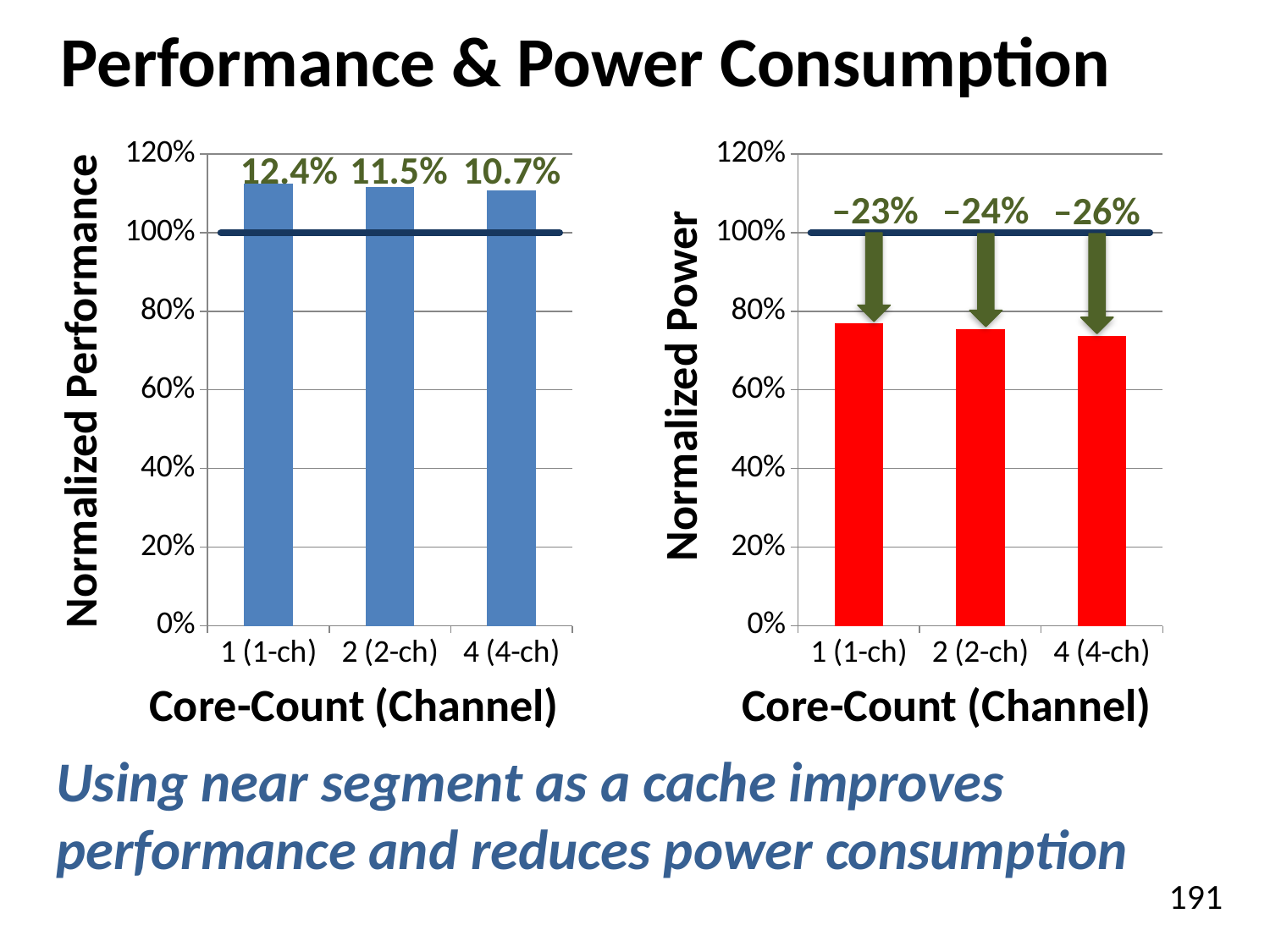
What is the x-axis title of the left chart (Normalized Performance)? Core-Count (Channel) On the left chart (Normalized Performance), what performance improvement is labeled above the bar for 4 (4-ch)? 10.7% On the right chart (Normalized Power), what power reduction is labeled above the bar for 4 (4-ch)? –26% On the right chart (Normalized Power), do the bar heights rise or fall as the core count increases from 1 to 4? fall On the right chart (Normalized Power), what power reduction is labeled above the bar for 2 (2-ch)? –24% How many core-count configurations are plotted on the right chart (Normalized Power)? 3 On the right chart (Normalized Power), is the bar for 1 (1-ch) greater or less than 80%? less On the left chart (Normalized Performance), is the bar for 2 (2-ch) greater or less than 100%? greater On the right chart (Normalized Power), which core-count configuration has the lowest bar? 4 (4-ch) On the left chart (Normalized Performance), what performance improvement is labeled above the bar for 1 (1-ch)? 12.4% What kind of chart is the left chart (Normalized Performance)? bar chart On the left chart (Normalized Performance), which core-count configuration has the highest bar? 1 (1-ch)